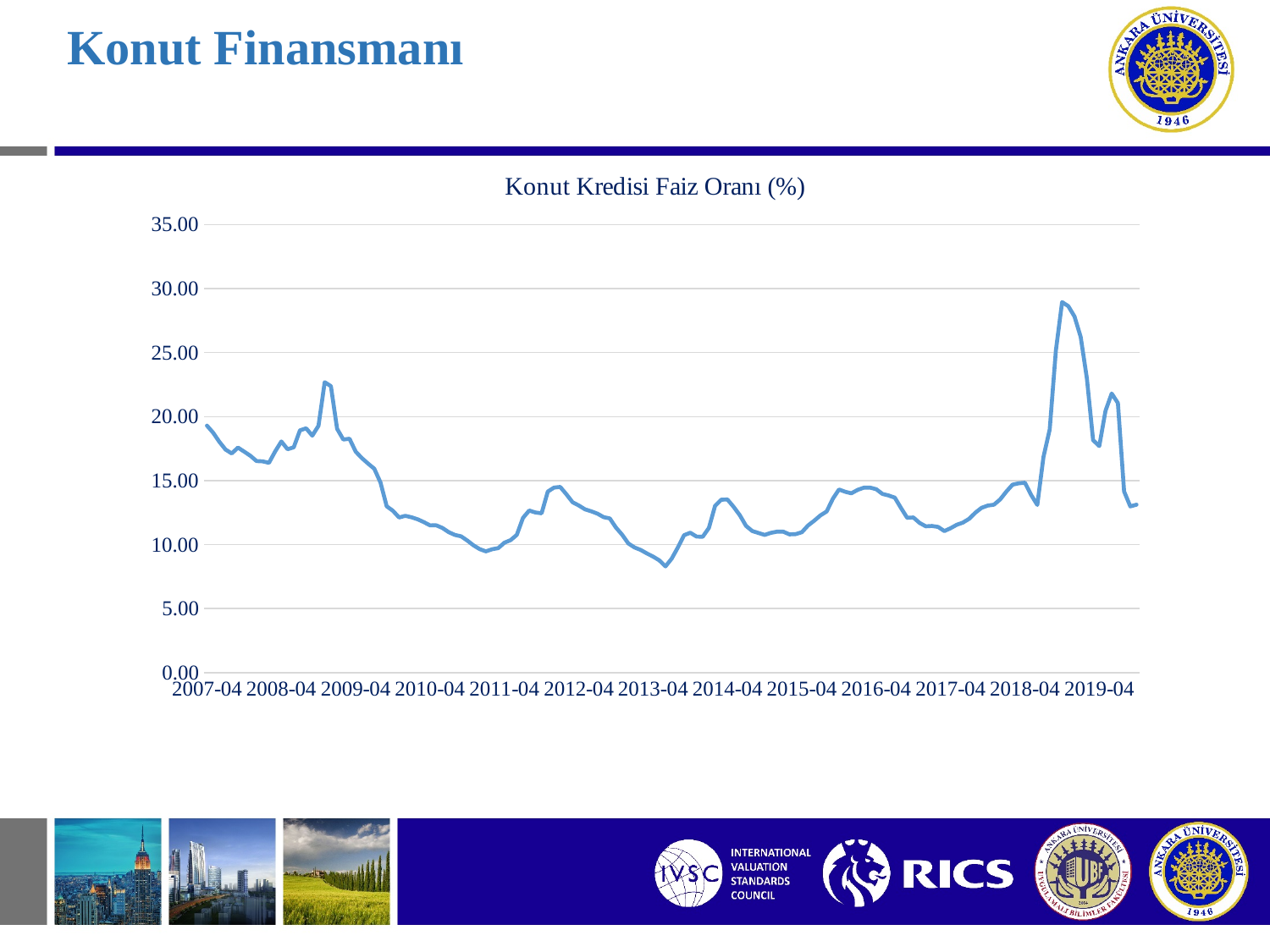
Is the value for 2007-04 greater or less than 15.00? greater Is the value for 2017-04 greater or less than 15.00? less Is the value for 2019-04 greater or less than 10.00? greater What kind of chart is shown on the slide? line chart How many date labels are shown on the x axis of the chart? 13 Between which two x-axis labels does the line reach its highest peak? 2018-04 and 2019-04 Which is larger, the value for 2007-04 or the value for 2013-04? 2007-04 What is the title of the chart? Konut Kredisi Faiz Oranı (%) Does the line overall rise or fall between 2007-04 and 2013-04? fall